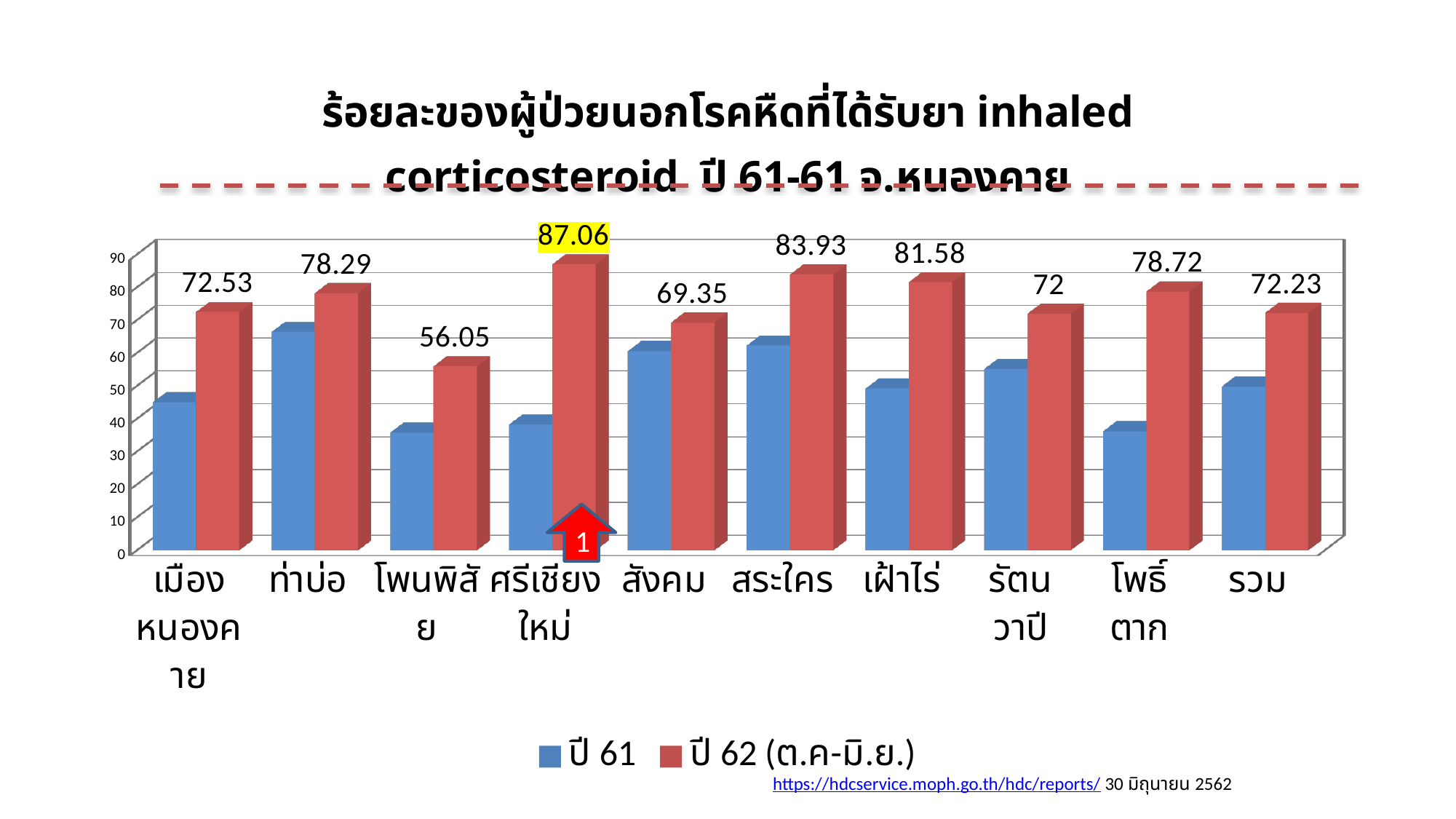
Which category has the lowest ปี 62 (ต.ค-มิ.ย.) value? โพนพิสัย Is the ปี 61 value for ท่าบ่อ greater or less than 60? greater Which category has the highest ปี 62 (ต.ค-มิ.ย.) value? ศรีเชียงใหม่ How many series does the legend list? 2 Which has the larger ปี 62 (ต.ค-มิ.ย.) value, ท่าบ่อ or โพธิ์ตาก? โพธิ์ตาก What is the ปี 62 (ต.ค-มิ.ย.) value for ศรีเชียงใหม่? 87.06 What kind of chart is shown on the slide? bar chart How many categories are shown on the x axis? 10 What is the ปี 62 (ต.ค-มิ.ย.) value for รวม? 72.23 What is the ปี 62 (ต.ค-มิ.ย.) value for สระใคร? 83.93 Is the ปี 61 value for โพนพิสัย greater or less than 50? less What is the difference between the ปี 62 (ต.ค-มิ.ย.) values for ศรีเชียงใหม่ and โพนพิสัย? 31.01